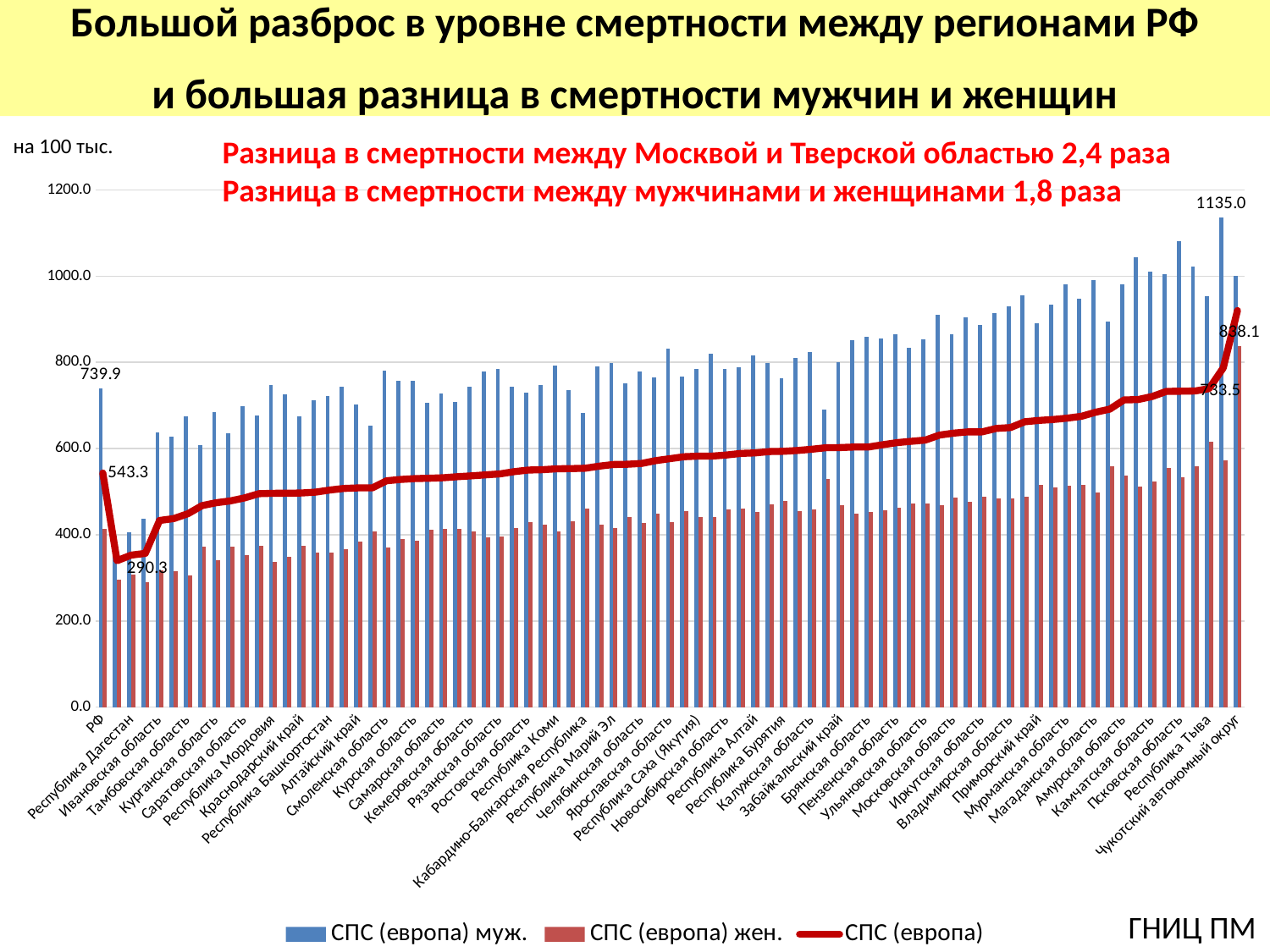
What is the value of the СПС (европа) муж. bar for РФ? 739.9 What is the value of the СПС (европа) line for РФ? 543.3 Does the СПС (европа) line generally rise or fall from left to right across the regions? rise What kind of chart is shown on the slide? bar chart with a line According to the red text on the slide, how many times does mortality differ between men and women? 1,8 раза What is the difference between the СПС (европа) муж. value for РФ and the СПС (европа) line value for РФ? 196.6 How many series does the legend list? 3 Is the СПС (европа) муж. value for Чукотский автономный округ greater or less than 800? greater For РФ, which is larger: the СПС (европа) муж. bar or the СПС (европа) жен. bar? СПС (европа) муж. What is the highest labelled value on the chart? 1135.0 Is the СПС (европа) жен. value for РФ greater or less than 600? less What unit is indicated at the top left of the chart's vertical axis? на 100 тыс.